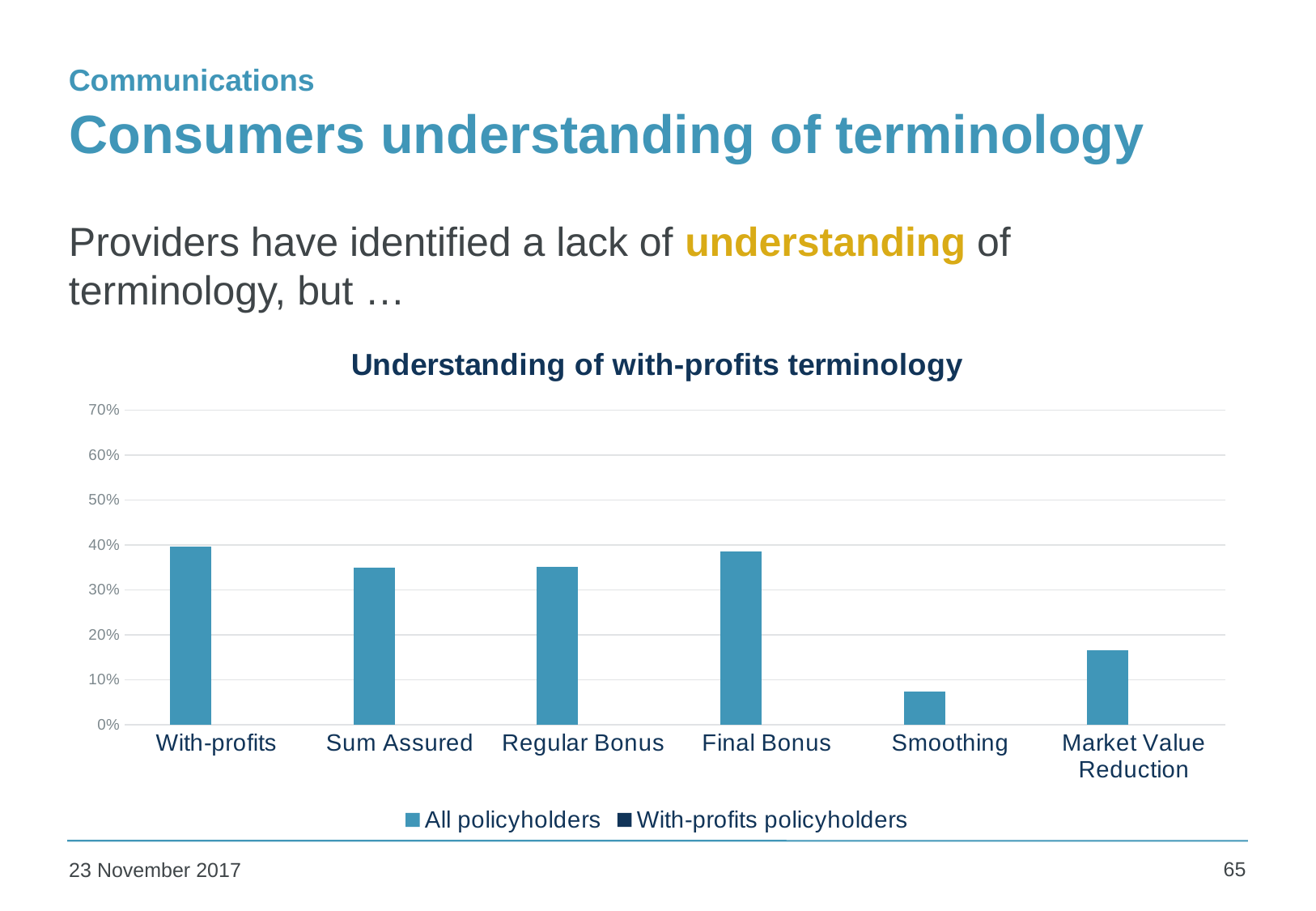
Which is larger, the value for Market Value Reduction or the value for Smoothing? Market Value Reduction What are the two series named in the chart's legend? All policyholders and With-profits policyholders How many series does the chart's legend list? 2 How many categories are shown on the x axis of the chart? 6 Is the value for Final Bonus greater or less than 30%? greater Is the value for Smoothing greater or less than 10%? less Is the value for With-profits greater or less than 30%? greater What kind of chart is shown on the slide? Bar chart What is the title of the chart? Understanding of with-profits terminology Which is larger, the value for With-profits or the value for Market Value Reduction? With-profits Which category has the lowest value in the chart? Smoothing